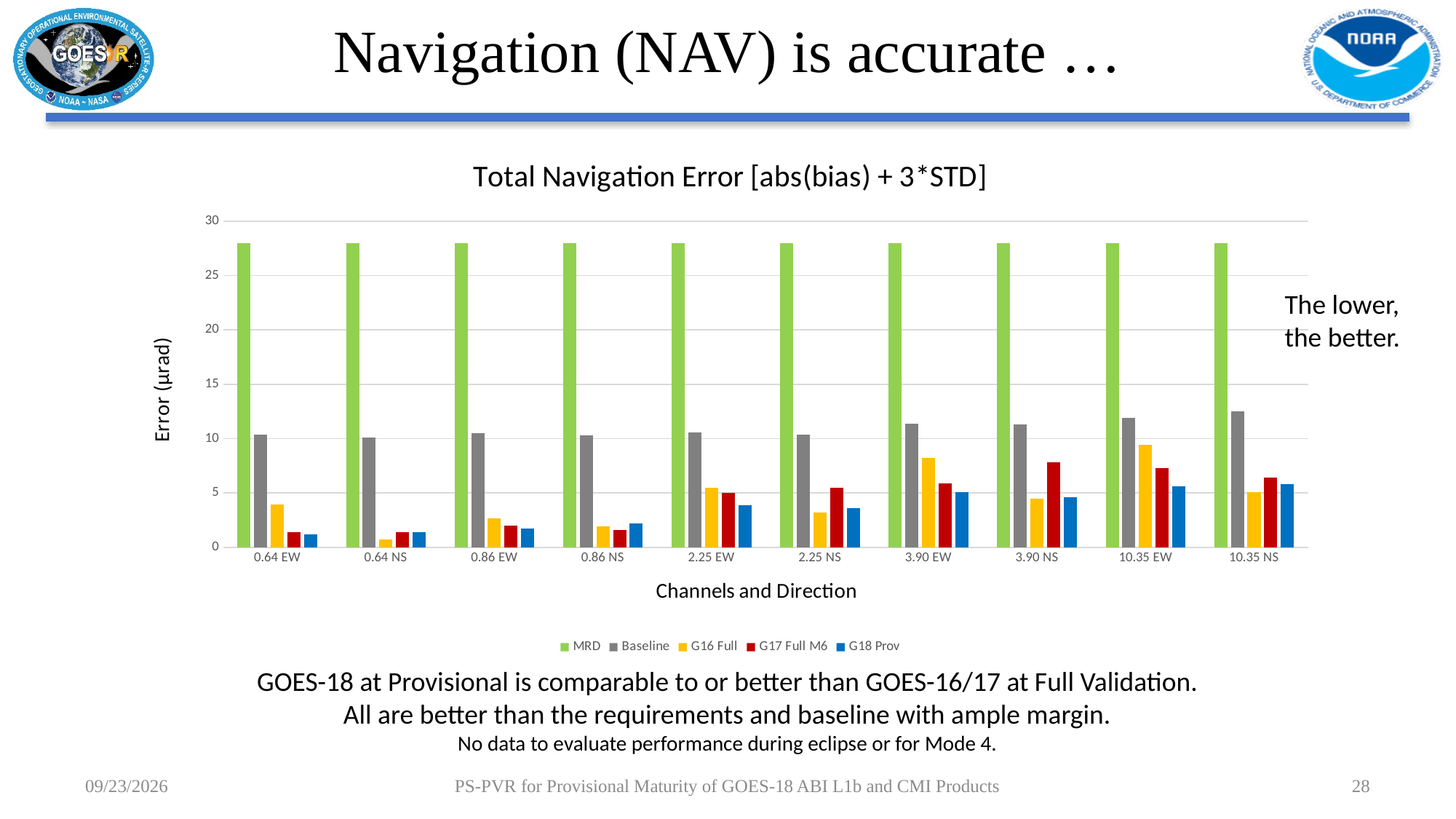
Is the MRD value for 2.25 EW greater or less than 25? greater For 0.64 EW, which is larger: G16 Full or G18 Prov? G16 Full Is the Baseline value for 10.35 NS greater or less than 10? greater Which category has the highest G16 Full value? 10.35 EW How many series does the legend list? 5 For 3.90 NS, which is larger: G17 Full M6 or G16 Full? G17 Full M6 Which category has the lowest G16 Full value? 0.64 NS How many categories are shown on the x axis? 10 What is the title of the chart? Total Navigation Error [abs(bias) + 3*STD] Is the G16 Full value for 0.64 NS greater or less than 5? less What is the label of the y axis? Error (µrad) What kind of chart is shown on the slide? bar chart